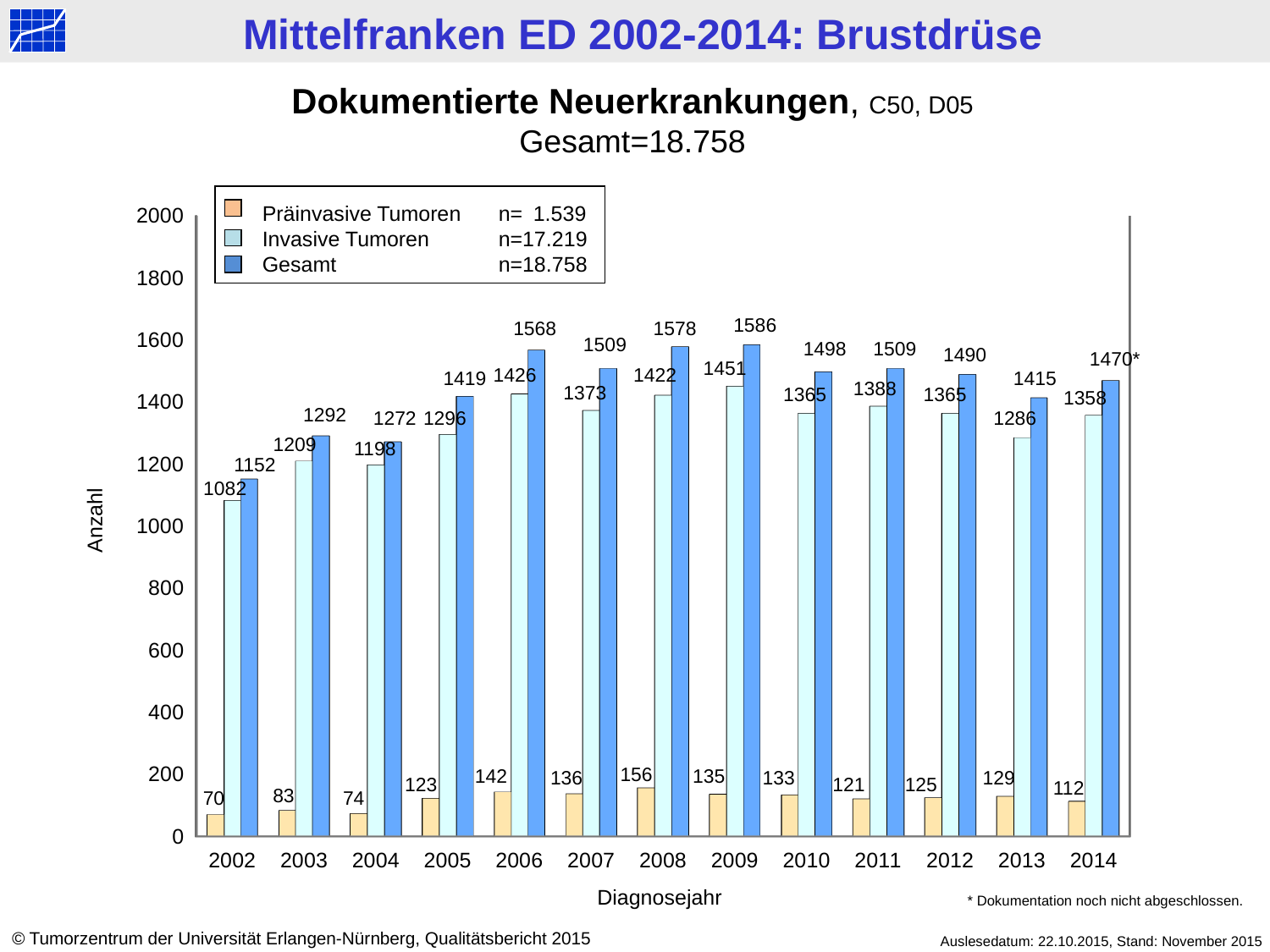
Which is larger, the Invasive Tumoren value for 2006 or for 2007? 2006 What kind of chart is shown on the slide? bar chart According to the legend, what is the n value for Invasive Tumoren? n=17.219 What is the value for Invasive Tumoren in 2002? 1082 What is the value for Präinvasive Tumoren in 2008? 156 In which year is the Präinvasive Tumoren value lowest? 2002 What is the difference between the Gesamt values for 2009 and 2002? 434 How many series does the legend list? 3 Is the Gesamt value for 2005 greater or less than 1400? greater In which year is the Gesamt value highest? 2009 How many diagnosis years are shown on the x axis? 13 What is the Gesamt value for 2009? 1586